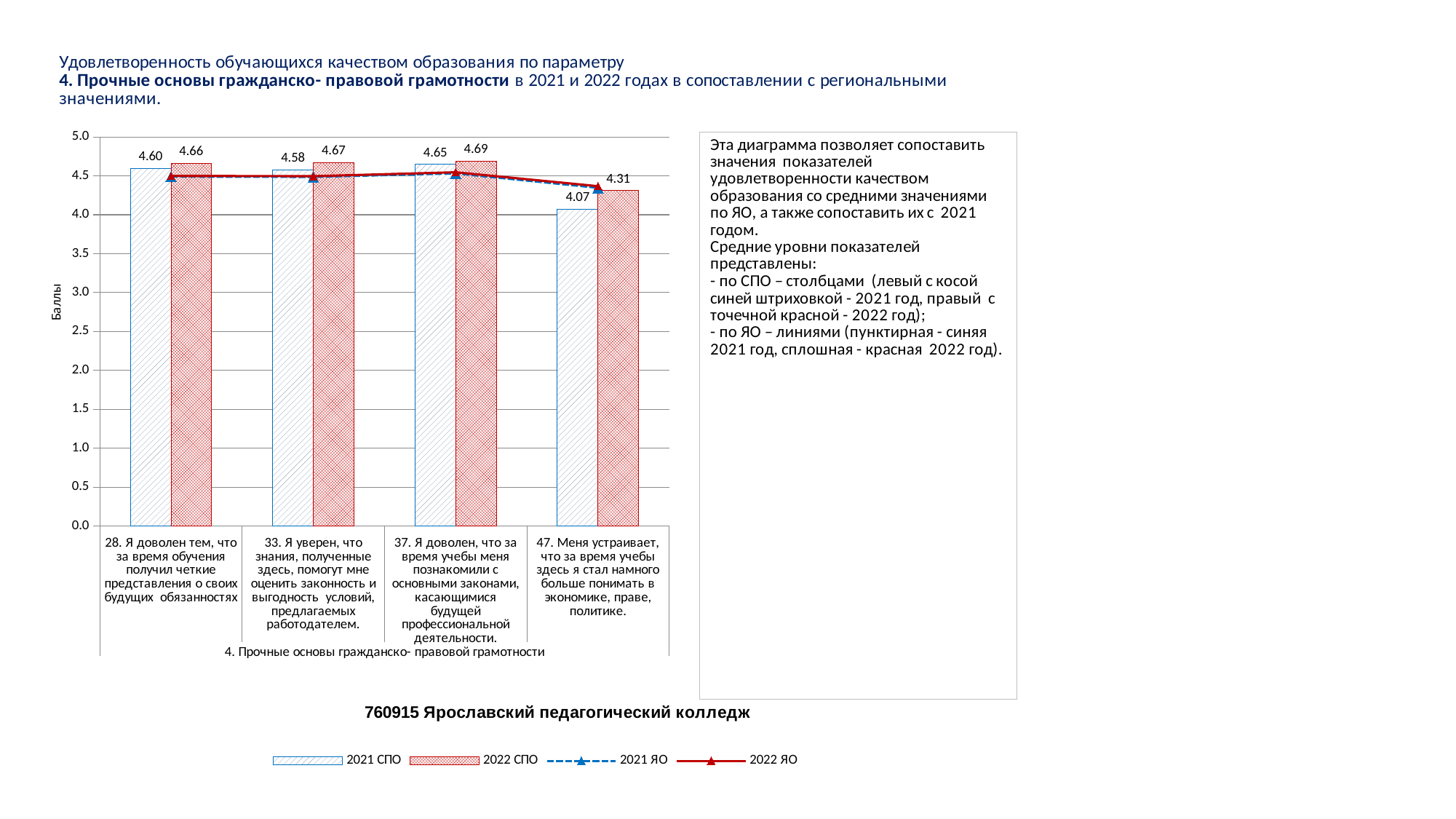
What is the 2021 СПО value for item 28 (Я доволен тем, что за время обучения получил четкие представления о своих будущих обязанностях)? 4.60 How many items (categories) are shown on the x axis? 4 What is the 2022 СПО value for item 47 (Меня устраивает, что за время учебы здесь я стал намного больше понимать в экономике, праве, политике)? 4.31 What is the difference between the 2022 СПО and 2021 СПО values for item 47? 0.24 Is the 2021 СПО value for item 47 greater or less than 4.5? less For item 37, which is larger: the 2021 СПО value or the 2022 СПО value? 2022 СПО What kind of chart is shown on the slide? Combined bar and line chart What is the label of the vertical axis? Баллы What is the 2022 СПО value for item 33 (Я уверен, что знания, полученные здесь, помогут мне оценить законность и выгодность условий, предлагаемых работодателем)? 4.67 How many series does the legend list? 4 Which item has the highest 2022 СПО value? 37. Я доволен, что за время учебы меня познакомили с основными законами, касающимися будущей профессиональной деятельности. Which item has the lowest 2021 СПО value? 47. Меня устраивает, что за время учебы здесь я стал намного больше понимать в экономике, праве, политике.